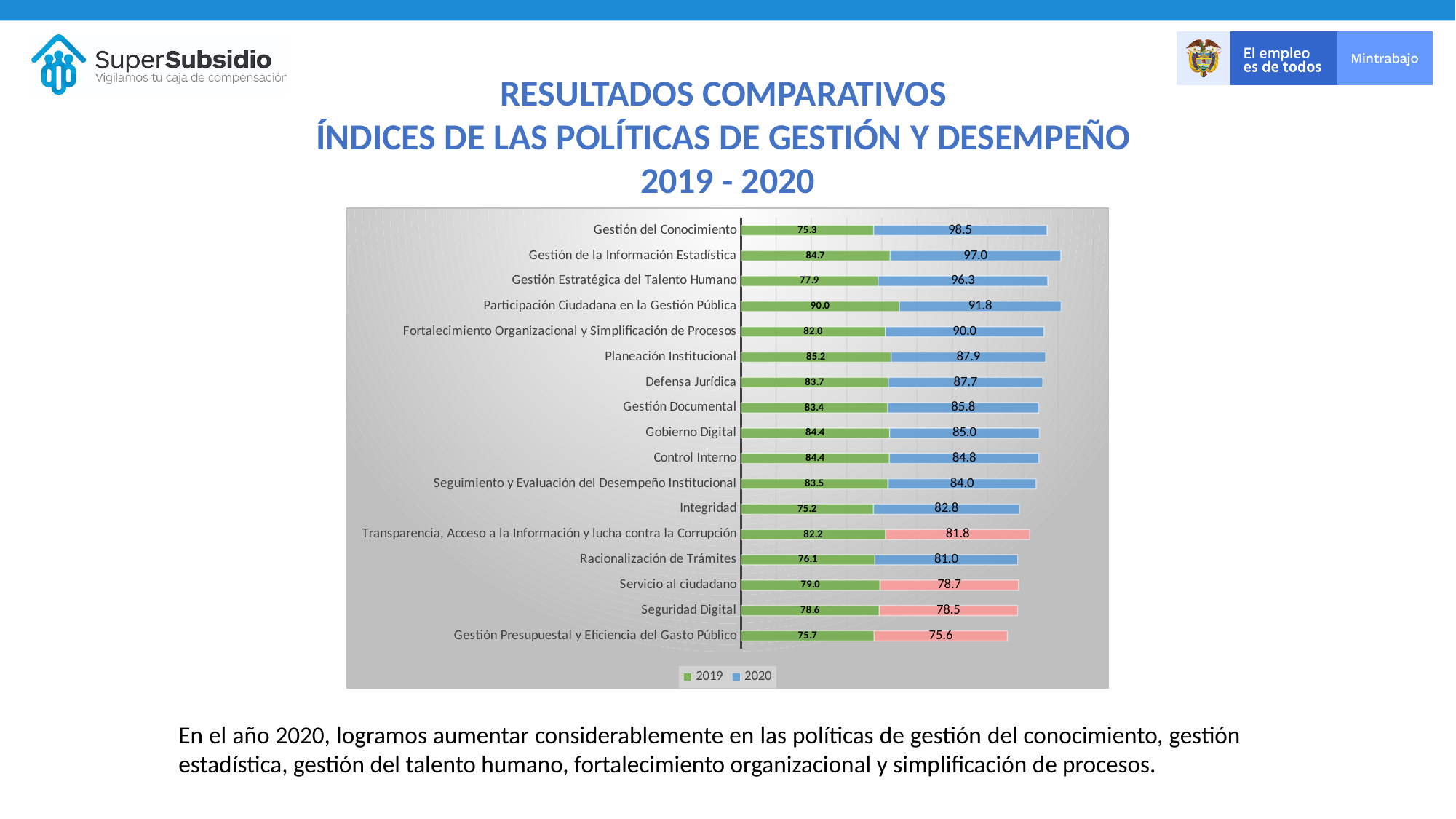
What is the 2019 value for Participación Ciudadana en la Gestión Pública? 90.0 What is the 2020 value for Gestión del Conocimiento? 98.5 Which category has the highest 2020 value? Gestión del Conocimiento How many series does the legend list? 2 What is the difference between the 2020 and 2019 values for Gestión del Conocimiento? 23.2 Which category has the highest 2019 value? Participación Ciudadana en la Gestión Pública For Seguridad Digital, which year has the larger value, 2019 or 2020? 2019 What is the difference between the 2020 and 2019 values for Gestión Estratégica del Talento Humano? 18.4 What kind of chart is shown on the slide? Bar chart Which category has the lowest 2020 value? Gestión Presupuestal y Eficiencia del Gasto Público What is the 2019 value for Integridad? 75.2 How many categories (policies) are shown in the chart? 17